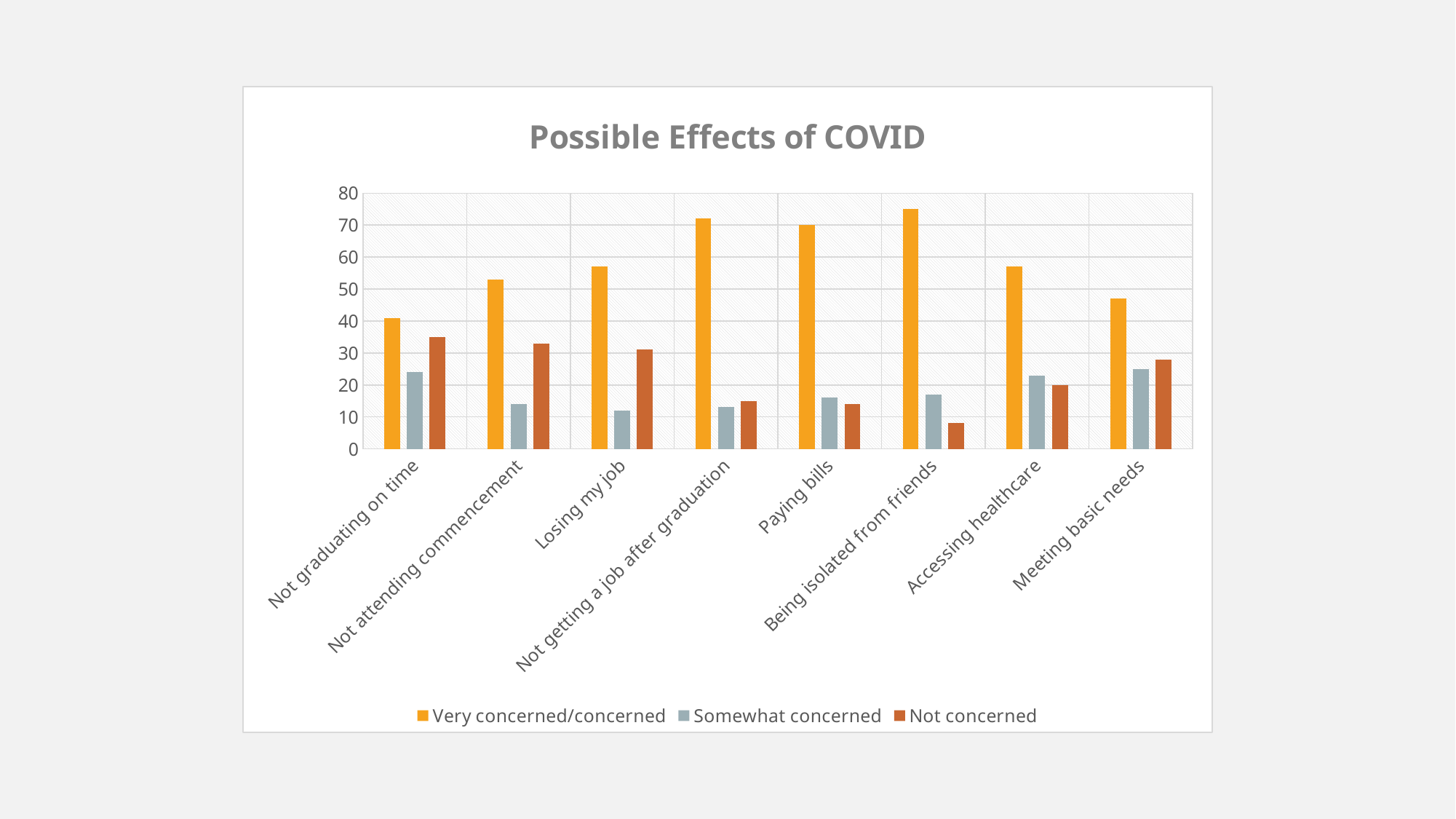
Which has the larger Very concerned/concerned value: Paying bills or Meeting basic needs? Paying bills Which category has the lowest value for the Not concerned series? Being isolated from friends How many categories are shown on the x axis? 8 Which category has the lowest value for the Very concerned/concerned series? Not graduating on time Is the Not concerned value for Being isolated from friends greater or less than 10? less How many series does the legend list? 3 Is the Very concerned/concerned value for Not graduating on time greater or less than 50? less Which category has the highest value for the Very concerned/concerned series? Being isolated from friends What kind of chart is shown on the slide? bar chart What is the title of the chart? Possible Effects of COVID Is the Very concerned/concerned value for Not getting a job after graduation greater or less than 60? greater For Not graduating on time, which is larger: the Somewhat concerned value or the Not concerned value? Not concerned